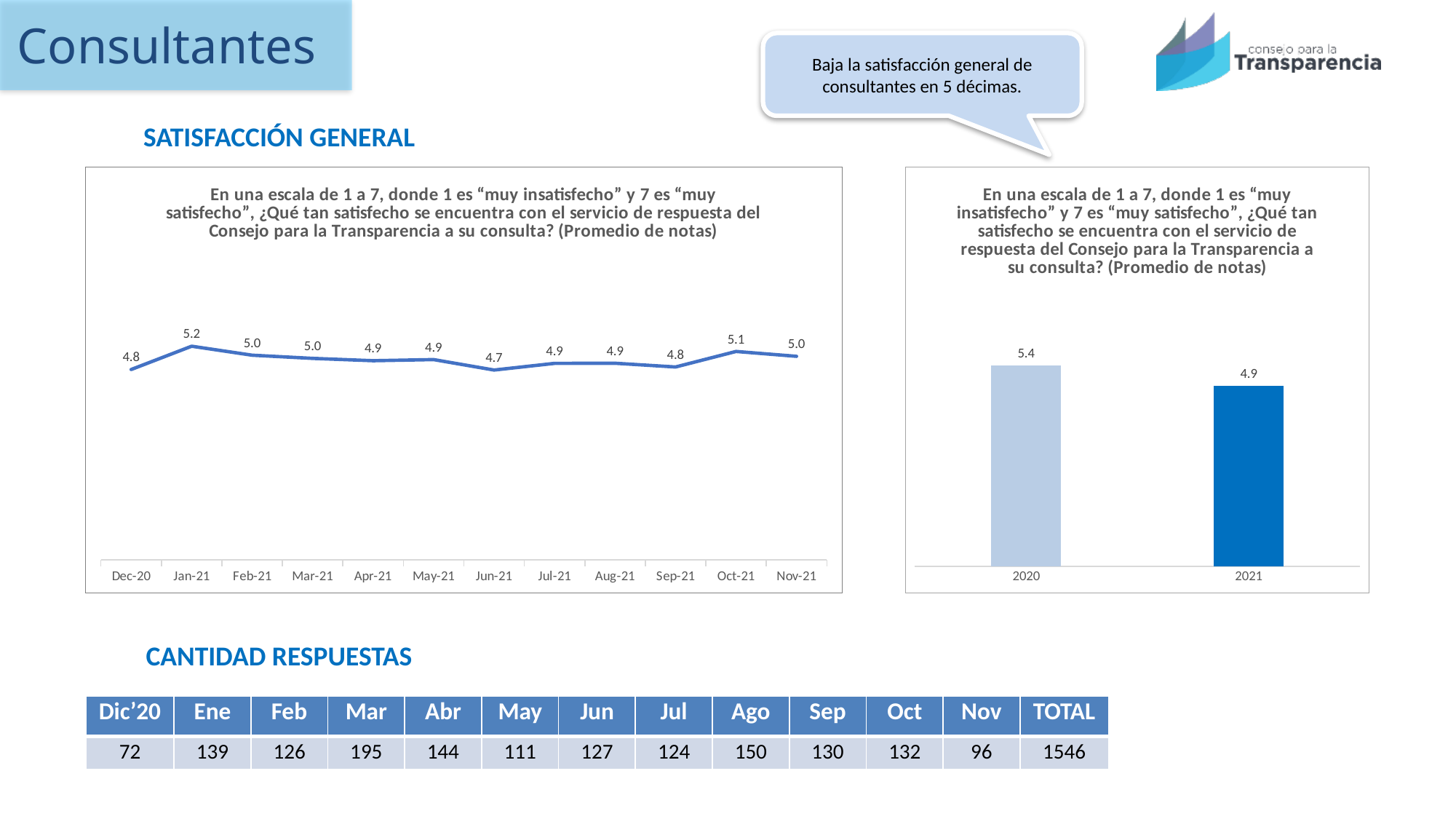
What kind of chart is the chart on the right? bar chart In the bar chart on the right, what is the difference between the values for 2020 and 2021? 0.5 In the line chart on the left, is the value for Oct-21 larger or smaller than the value for Sep-21? larger In the line chart on the left, how many data points are plotted? 12 In the line chart on the left, which month has the lowest value? Jun-21 In the line chart on the left, what is the difference between the values for Jan-21 and Jun-21? 0.5 In the bar chart on the right, what is the value for 2020? 5.4 In the line chart on the left, what is the value for Jan-21? 5.2 In the bar chart on the right, what is the value for 2021? 4.9 In the line chart on the left, what is the value for Nov-21? 5.0 In the line chart on the left, which month has the highest value? Jan-21 In the line chart on the left, what is the value for Jun-21? 4.7